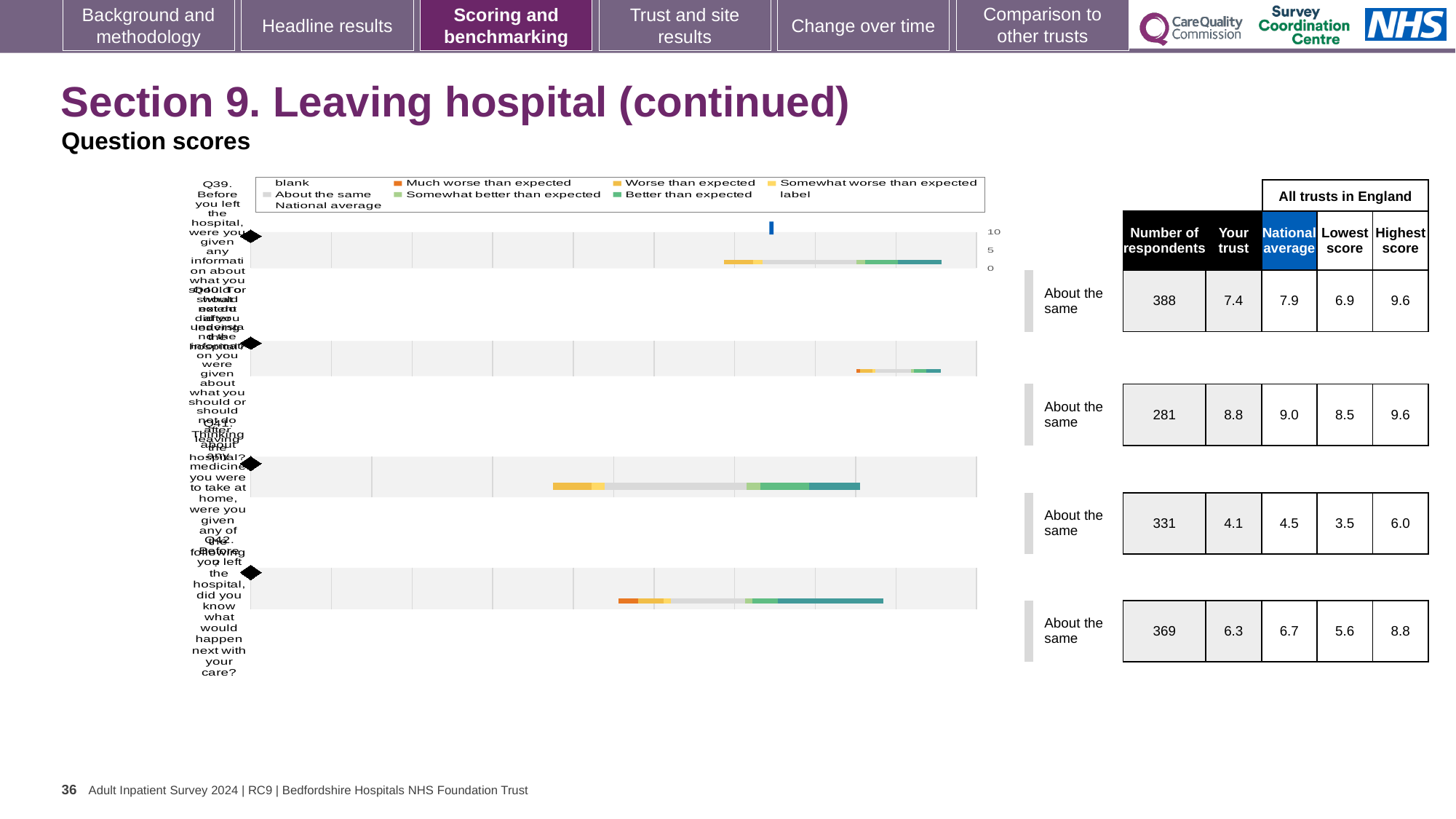
In the table beside the chart, what is the difference between the national average and the trust score for Q39? 0.5 In the table beside the chart, what is the national average for Q42 (Before you left the hospital, did you know what would happen next with your care)? 6.7 In the table beside the chart, which question row has the lowest 'Your trust' score? Q41 In the table beside the chart, is the trust score for Q42 higher or lower than the national average? lower In the table beside the chart, what is the highest score in England for the third question row (Q41)? 6.0 How many question rows (bars) does the chart show? 4 What benchmark category is shown next to each bar in the chart? About the same In the chart legend, what colour represents 'Better than expected'? teal In the chart legend, what colour represents 'Much worse than expected'? orange In the table beside the chart, what is the 'Your trust' score for Q39 (Before you left the hospital, were you given any information about what you should or should not do after leaving hospital)? 7.4 In the table beside the chart, how many respondents answered Q42? 369 What kind of chart is shown on the slide? bar chart